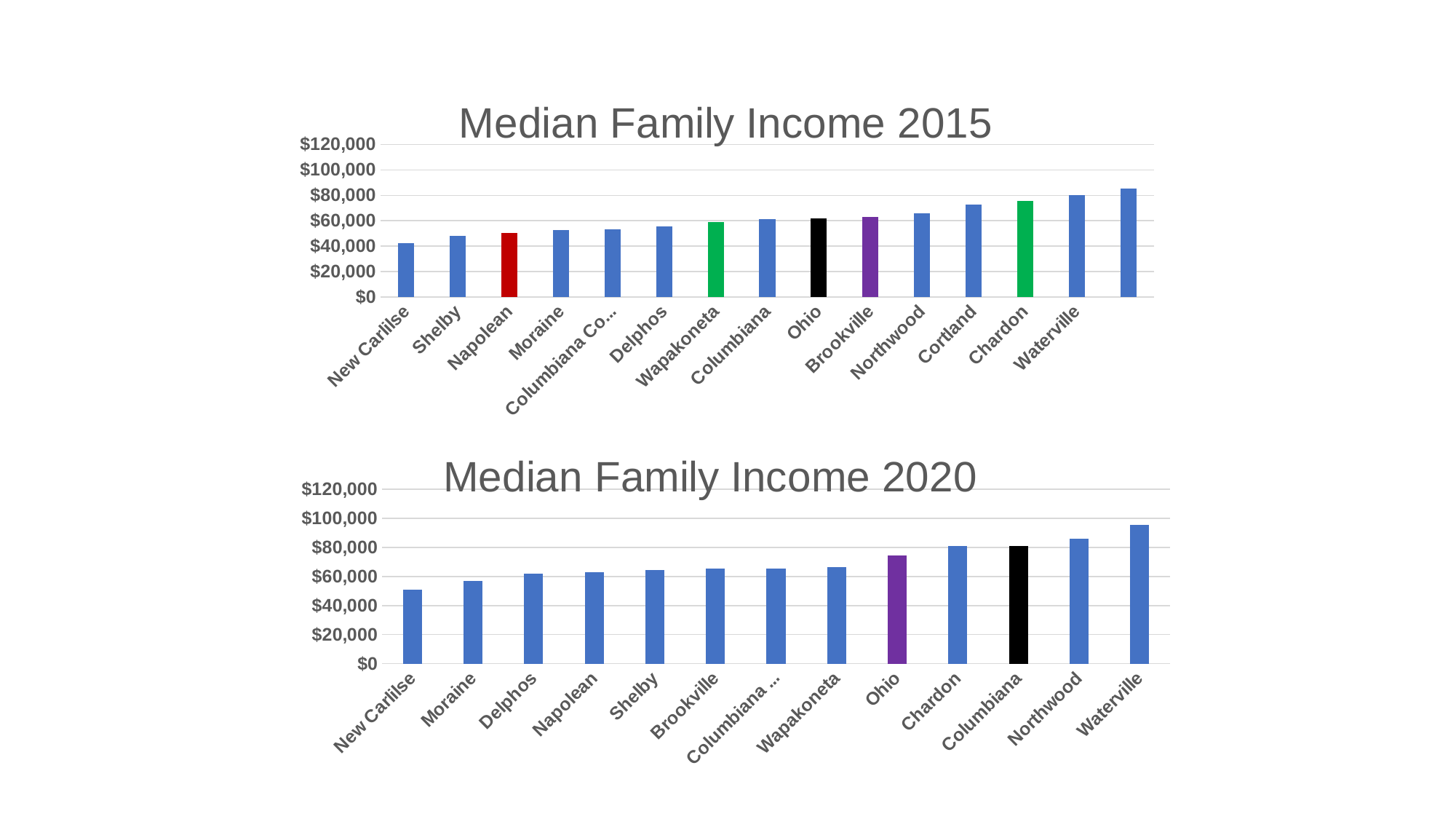
In the Median Family Income 2015 chart, is the value for Napolean greater or less than $60,000? less In the Median Family Income 2020 chart, is the value for Waterville greater or less than $80,000? greater How many cities or regions are shown in the Median Family Income 2015 chart? 14 What kind of chart is the Median Family Income 2015 chart? bar chart In the Median Family Income 2015 chart, which is larger, the value for Cortland or the value for Shelby? Cortland In the Median Family Income 2015 chart, which category has the lowest value? New Carlilse How many cities or regions are shown in the Median Family Income 2020 chart? 13 In the Median Family Income 2020 chart, which category has the lowest value? New Carlilse In the Median Family Income 2020 chart, which category has the highest value? Waterville In the Median Family Income 2020 chart, do the values rise or fall from left to right? rise In the Median Family Income 2015 chart, what colour is the bar for Napolean? red